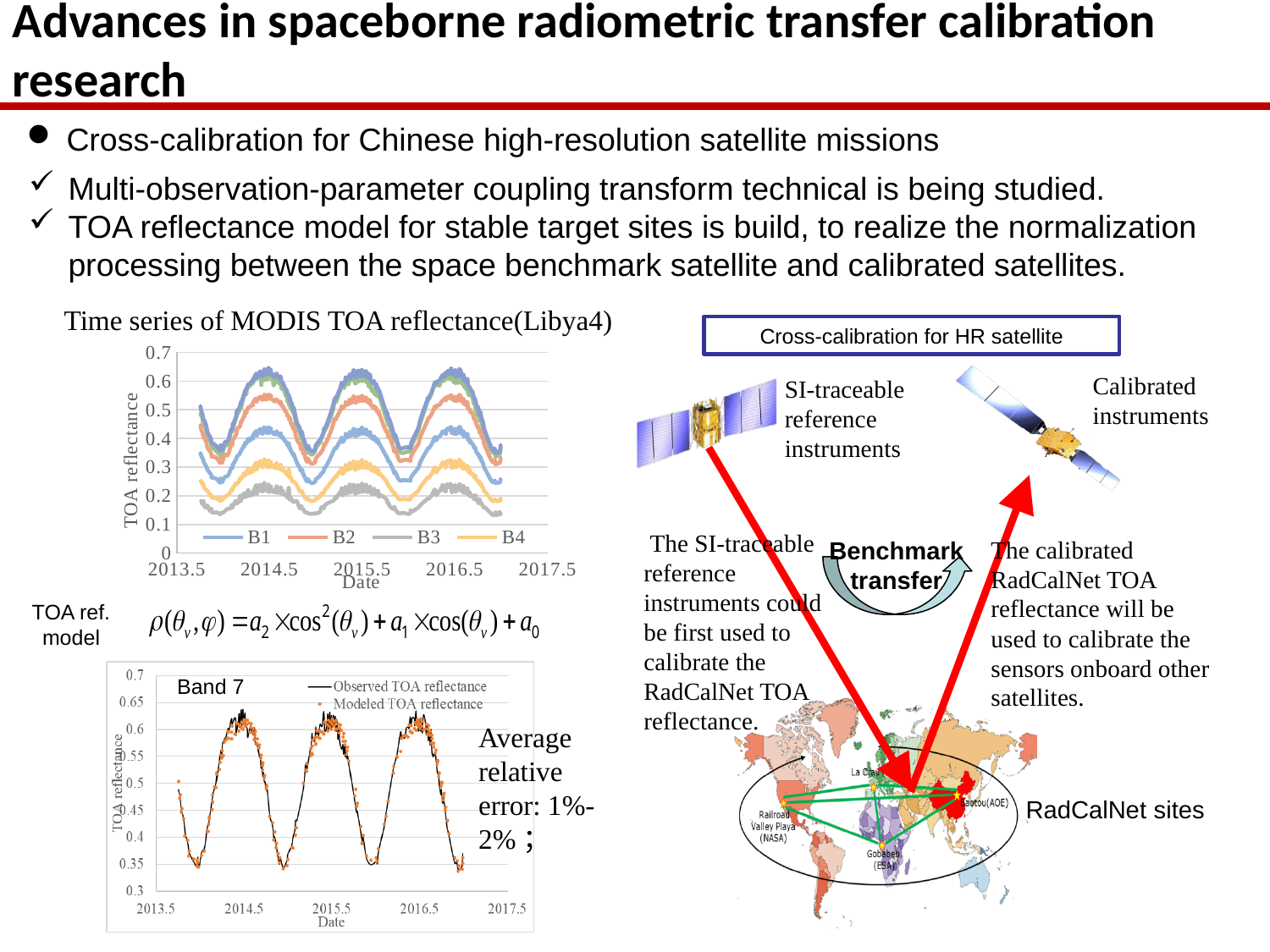
In the 'Time series of MODIS TOA reflectance(Libya4)' chart, which of the four legend series has the lowest TOA reflectance? B3 In the 'Time series of MODIS TOA reflectance(Libya4)' chart, are the peak values for B2 greater or less than 0.6? less In the 'Time series of MODIS TOA reflectance(Libya4)' chart, are the values for B3 greater or less than 0.3? less In the 'Time series of MODIS TOA reflectance(Libya4)' chart, which series has higher TOA reflectance, B3 or B4? B4 In the 'Time series of MODIS TOA reflectance(Libya4)' chart, which series has higher TOA reflectance, B2 or B3? B2 How many series does the legend of the 'Time series of MODIS TOA reflectance(Libya4)' chart list? 4 What kind of chart is the 'Time series of MODIS TOA reflectance(Libya4)' chart? line chart How many series does the legend of the Band 7 chart at the bottom left list? 2 In the Band 7 chart at the bottom left, are the peak values of the observed TOA reflectance greater or less than 0.6? greater What are the two legend entries of the Band 7 chart at the bottom left? Observed TOA reflectance, Modeled TOA reflectance In the Band 7 chart at the bottom left, do the values rise steadily, fall steadily, or follow a repeating cycle along the x axis? repeating cycle What is the y-axis label of the 'Time series of MODIS TOA reflectance(Libya4)' chart? TOA reflectance